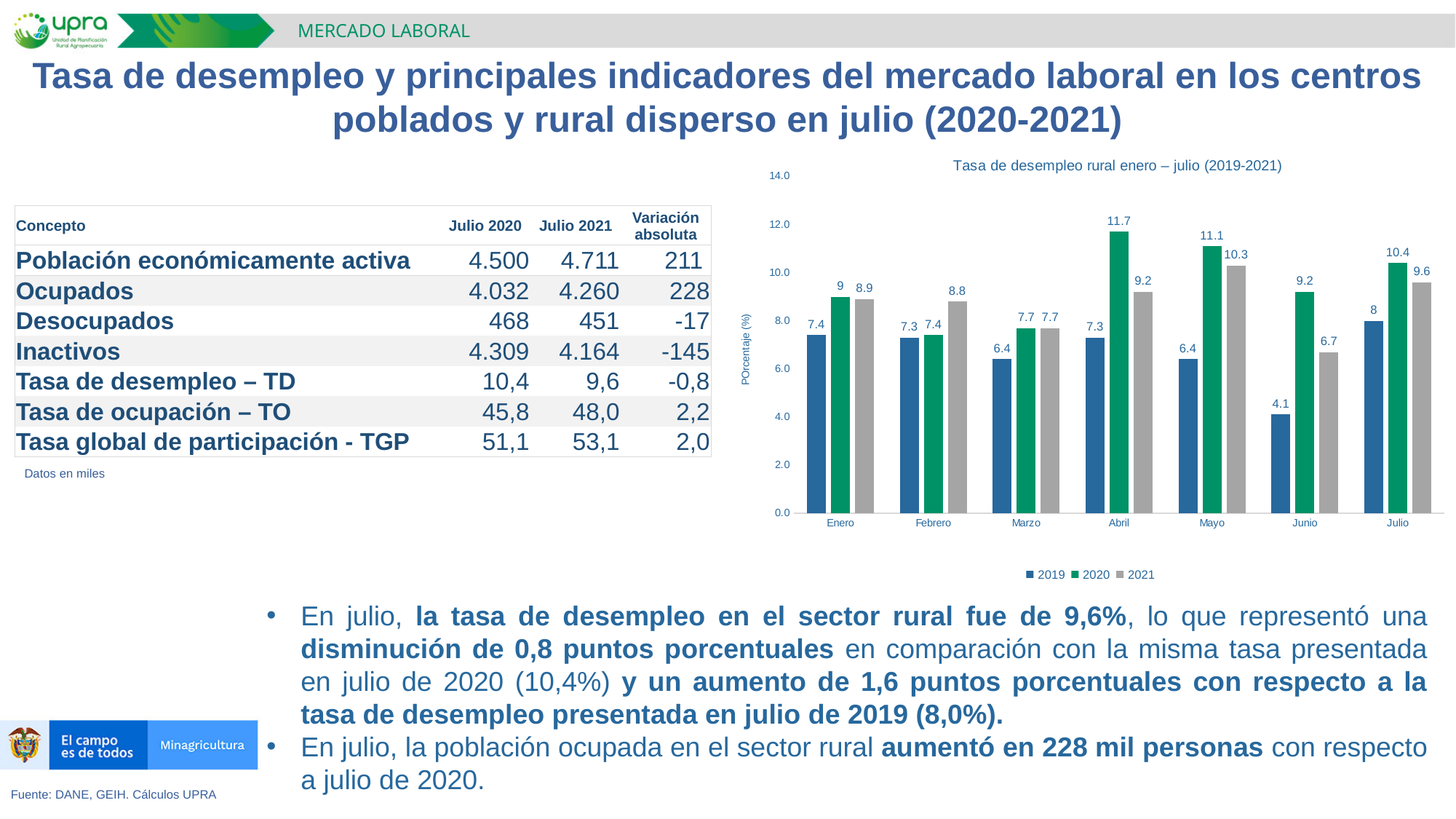
Which is larger in Febrero, the value for 2020 or the value for 2021? 2021 In which month is the 2020 series highest? Abril What is the difference between the 2020 and 2021 values in Mayo? 0.8 In which month is the 2019 series lowest? Junio What is the value for 2020 in Abril? 11.7 How many series does the chart legend list? 3 What is the title of the chart? Tasa de desempleo rural enero – julio (2019-2021) What is the value for 2021 in Julio? 9.6 Is the value for 2020 in Mayo greater or less than 10.0? greater How many months are shown on the x axis of the chart? 7 What type of chart is shown on the slide? bar chart What is the value for 2019 in Junio? 4.1